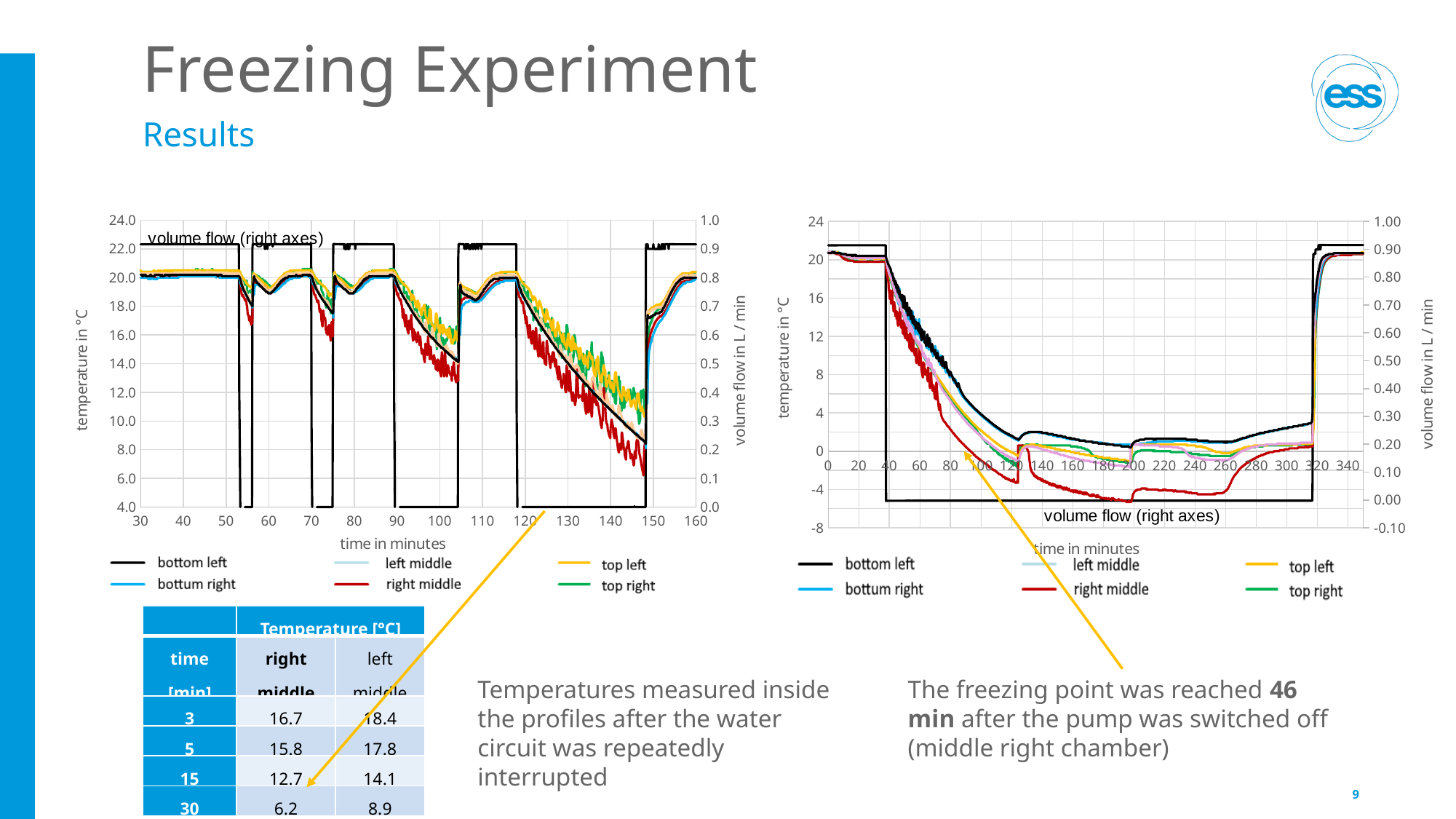
In the right chart, which series reaches the lowest temperature? right middle In the right chart, does the temperature for right middle rise or fall between 40 and 120 minutes? fall In the right chart, is the temperature for right middle at 240 minutes greater or less than 0? less In the right chart, is the temperature for bottom left at 20 minutes greater or less than 16? greater In the left chart, is the temperature for right middle at 140 minutes greater or less than 14.0? less In the right chart, at 240 minutes, which is higher: bottom left or right middle? bottom left What is the label of the right-hand vertical axis of the right chart? volume flow in L / min What kind of chart is the left chart on the slide? line chart How many series does the legend of the right chart list? 6 How many series does the legend of the left chart list? 6 What is the x-axis label of the left chart? time in minutes